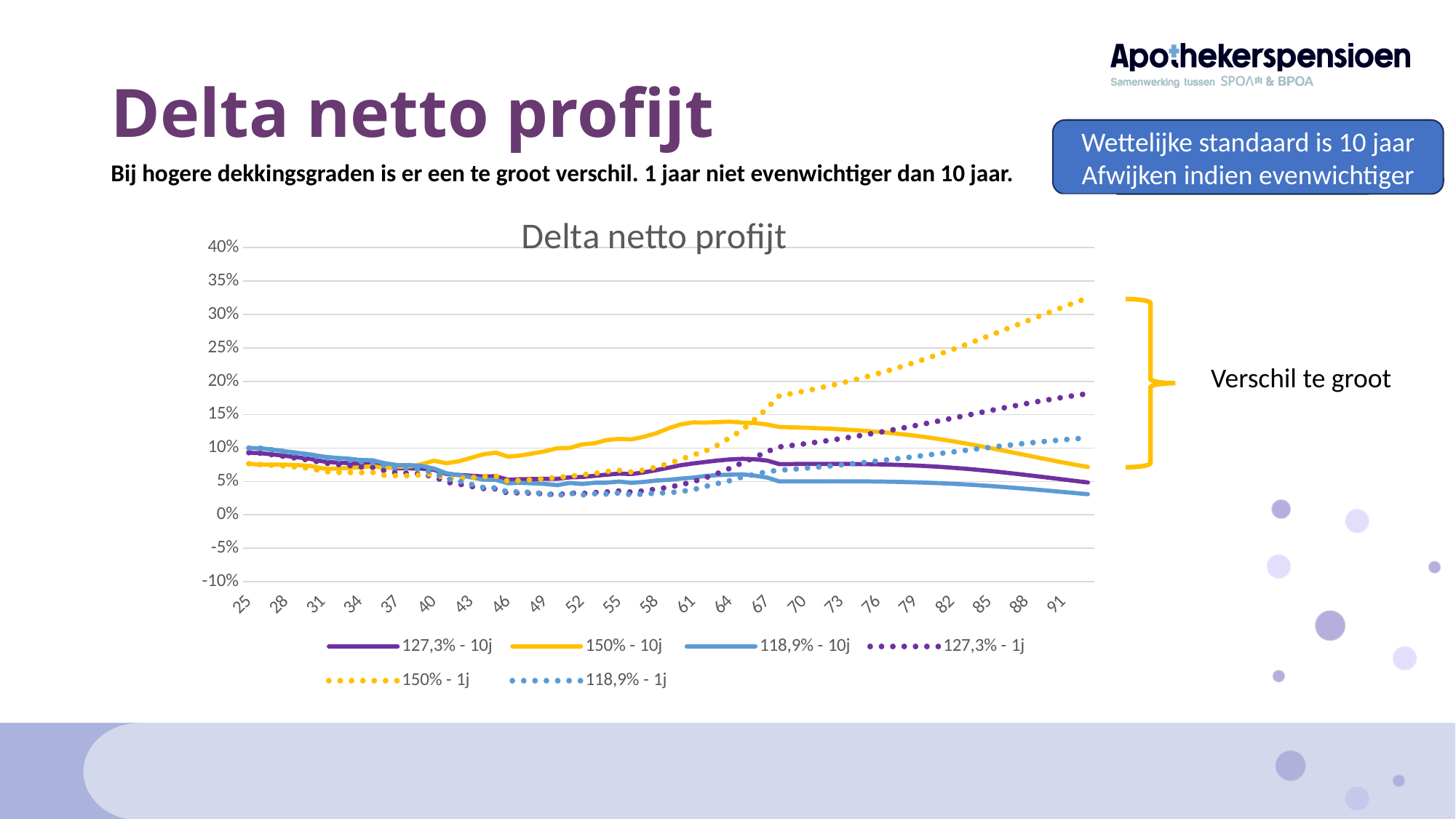
Does the 150% - 1j series rise or fall between age 67 and age 91? rise Which series has the lowest value at the right end of the chart (age 91)? 118,9% - 10j At age 91, which is larger: 150% - 10j or 127,3% - 1j? 127,3% - 1j Does the 118,9% - 10j series rise or fall between age 70 and age 91? fall How many series does the legend of the chart list? 6 Is the value for 118,9% - 10j at age 91 greater or less than 5%? less Is the value for 127,3% - 1j at age 91 greater or less than 15%? greater What kind of chart is shown on the slide? line chart Which series reaches the highest value at the right end of the chart (age 91)? 150% - 1j Is the value for 150% - 1j at age 91 greater or less than 30%? greater What is the title of the chart? Delta netto profijt What is the highest value shown on the y axis of the chart? 40%